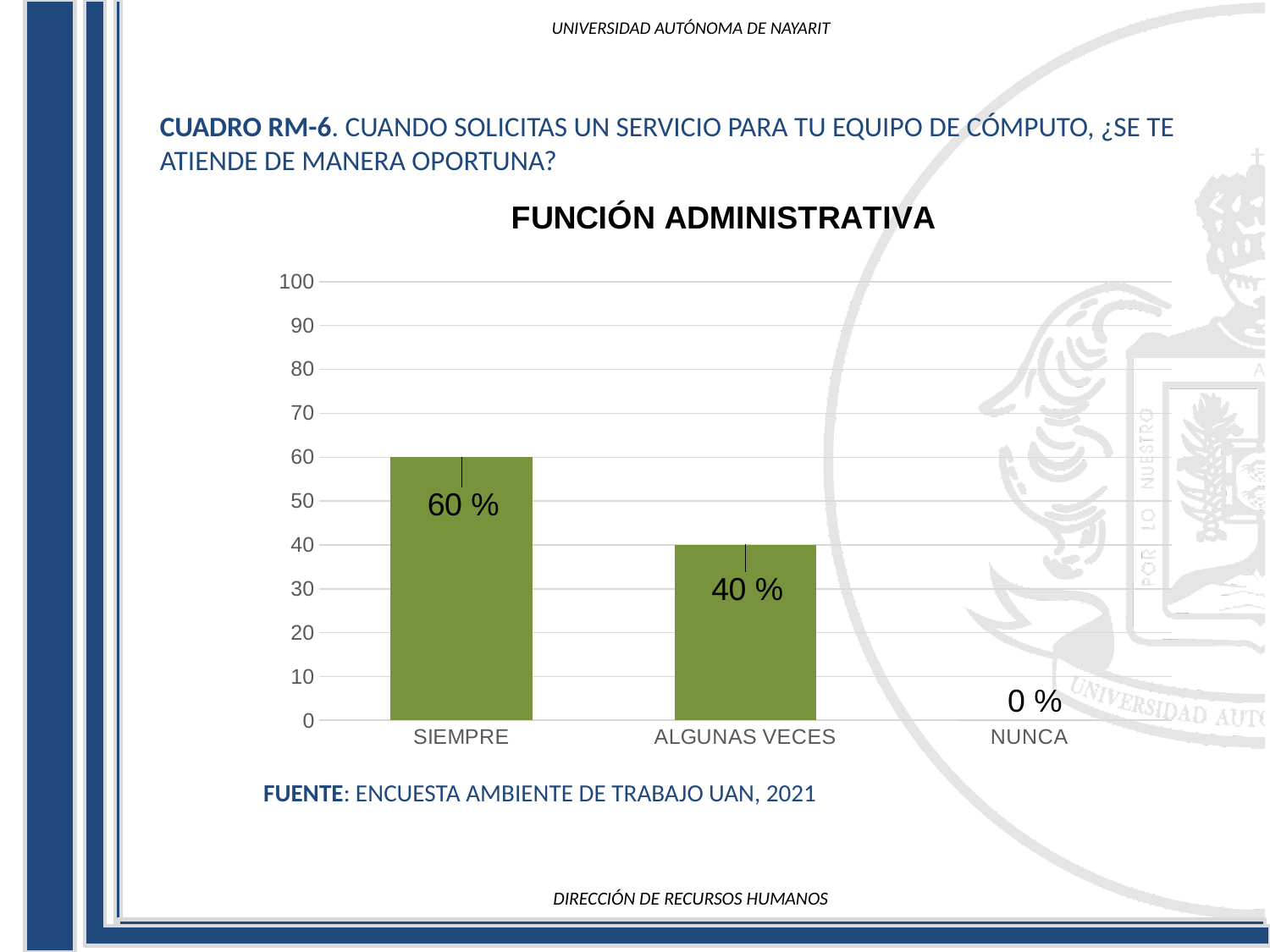
What kind of chart is shown? bar chart What is the value for SIEMPRE? 60 % What is the value for ALGUNAS VECES? 40 % How many categories are shown on the x axis? 3 What is the value for NUNCA? 0 % Which category has the highest value? SIEMPRE Is the value for ALGUNAS VECES greater or less than 50? less Do the values rise or fall from left to right along the x axis? fall Which category has the lowest value? NUNCA What is the title of the chart? FUNCIÓN ADMINISTRATIVA What is the difference between the values for SIEMPRE and ALGUNAS VECES? 20 % Which is larger, the value for SIEMPRE or the value for ALGUNAS VECES? SIEMPRE